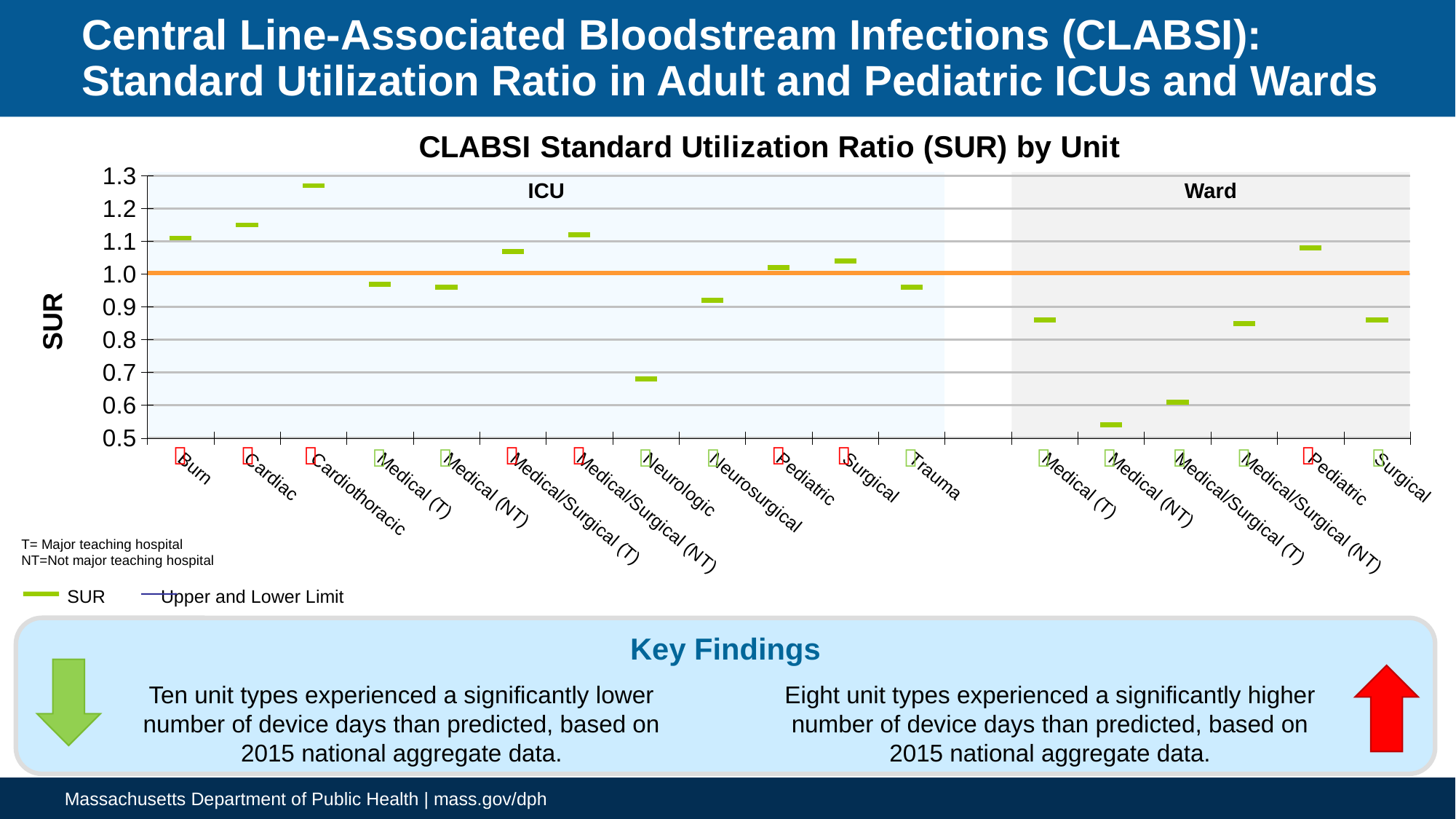
Is the SUR for the Medical (T) Ward greater or less than 0.9? less Which unit has the highest SUR in the chart? Cardiothoracic (ICU) How many unit types are plotted in the chart in total? 18 What is the label on the vertical axis of the chart? SUR Which has a higher SUR, the Neurologic ICU or the Neurosurgical ICU? Neurosurgical ICU How many entries does the chart legend list? 2 Which unit has the lowest SUR in the chart? Medical (NT) Ward Which has a higher SUR, the Medical (NT) Ward or the Medical/Surgical (T) Ward? Medical/Surgical (T) Ward Is the SUR for the Cardiothoracic ICU greater or less than 1.2? greater Is the SUR for the Neurologic ICU greater or less than 0.7? less